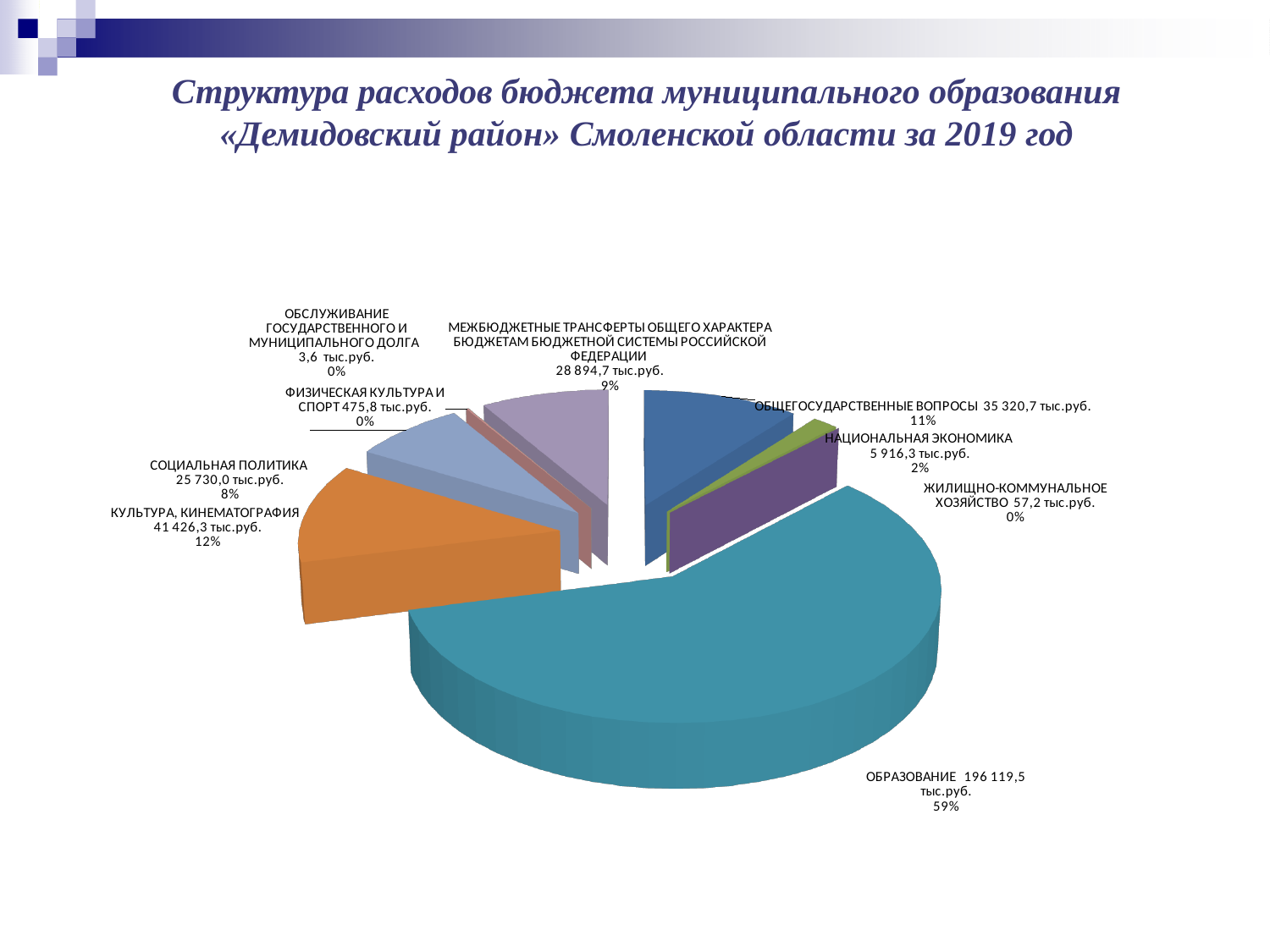
What is the title of the chart on the slide? Структура расходов бюджета муниципального образования «Демидовский район» Смоленской области за 2019 год What is the difference between the values for КУЛЬТУРА, КИНЕМАТОГРАФИЯ and ОБЩЕГОСУДАРСТВЕННЫЕ ВОПРОСЫ? 6 105,6 тыс.руб. What is the value for КУЛЬТУРА, КИНЕМАТОГРАФИЯ? 41 426,3 тыс.руб. Which is larger: СОЦИАЛЬНАЯ ПОЛИТИКА or МЕЖБЮДЖЕТНЫЕ ТРАНСФЕРТЫ ОБЩЕГО ХАРАКТЕРА БЮДЖЕТАМ БЮДЖЕТНОЙ СИСТЕМЫ РОССИЙСКОЙ ФЕДЕРАЦИИ? МЕЖБЮДЖЕТНЫЕ ТРАНСФЕРТЫ ОБЩЕГО ХАРАКТЕРА БЮДЖЕТАМ БЮДЖЕТНОЙ СИСТЕМЫ РОССИЙСКОЙ ФЕДЕРАЦИИ What is the value for ОБРАЗОВАНИЕ? 196 119,5 тыс.руб. Which category has the largest share of the pie? ОБРАЗОВАНИЕ What share of the pie does СОЦИАЛЬНАЯ ПОЛИТИКА represent? 8% What share of the pie does ОБРАЗОВАНИЕ represent? 59% Which category has the smallest value? ОБСЛУЖИВАНИЕ ГОСУДАРСТВЕННОГО И МУНИЦИПАЛЬНОГО ДОЛГА What is the value for МЕЖБЮДЖЕТНЫЕ ТРАНСФЕРТЫ ОБЩЕГО ХАРАКТЕРА БЮДЖЕТАМ БЮДЖЕТНОЙ СИСТЕМЫ РОССИЙСКОЙ ФЕДЕРАЦИИ? 28 894,7 тыс.руб. What kind of chart is shown on the slide? Pie chart How many categories (slices) does the pie chart show? 9